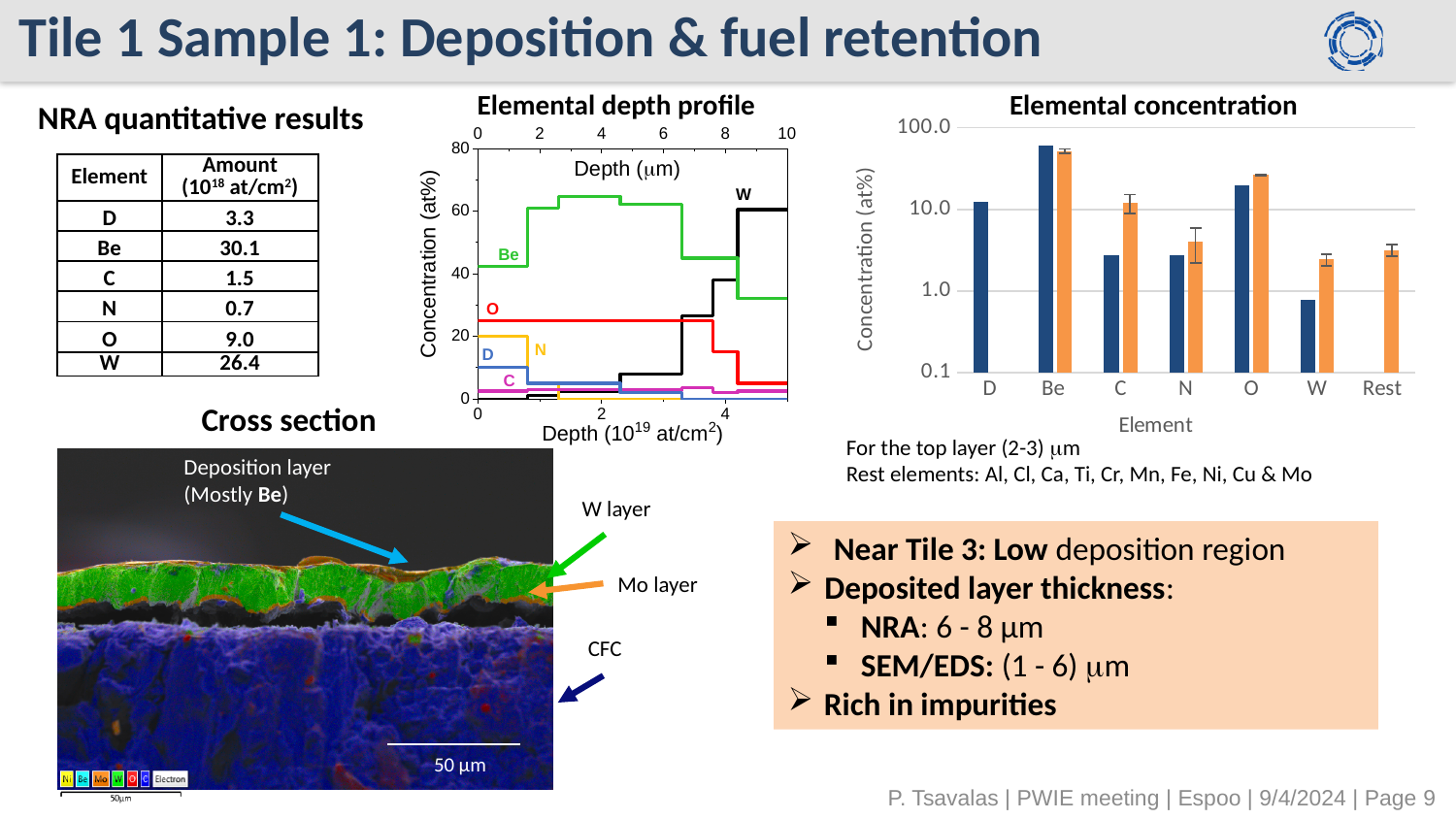
What kind of chart is the 'Elemental depth profile' chart? line chart In the 'Elemental depth profile' chart, does the W concentration rise or fall as depth increases? rises In the 'Elemental concentration' chart, is the blue bar for W greater or less than 1.0? less What is the y-axis label of the 'Elemental concentration' chart? Concentration (at%) What kind of chart is the 'Elemental concentration' chart? bar chart In the 'Elemental concentration' chart, which element has the shortest blue bar? W In the 'Elemental concentration' chart, is the orange bar for O greater or less than 10.0? greater In the 'Elemental depth profile' chart, which element has the highest concentration in the middle of the depth range? Be In the 'Elemental concentration' chart, how many elements are listed on the x axis? 7 In the 'Elemental concentration' chart, is the blue bar for C greater or less than 10.0? less In the 'Elemental concentration' chart, which element has the tallest blue bar? Be In the 'Elemental concentration' chart, which is larger, the blue bar for Be or the blue bar for D? Be